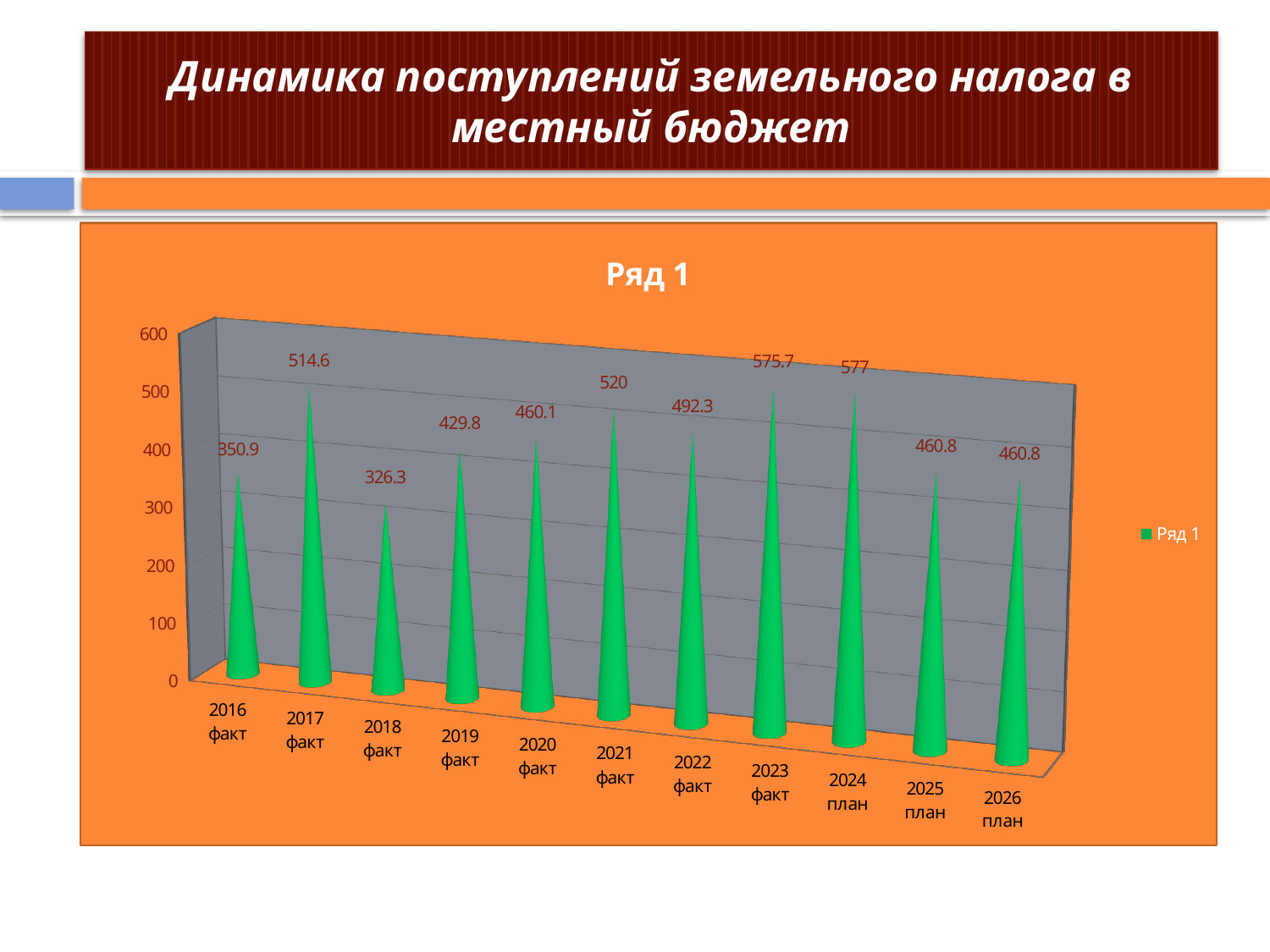
How many categories are shown on the x axis? 11 What kind of chart is shown on the slide? bar chart What is the value for 2017 факт? 514.6 What is the title of the chart? Ряд 1 What is the value for 2023 факт? 575.7 Which category has the highest value? 2024 план What is the value for 2021 факт? 520 Which is larger, the value for 2019 факт or the value for 2020 факт? 2020 факт How many series does the legend list? 1 What is the difference between the values for 2017 факт and 2018 факт? 188.3 What is the value for 2026 план? 460.8 Which category has the lowest value? 2018 факт